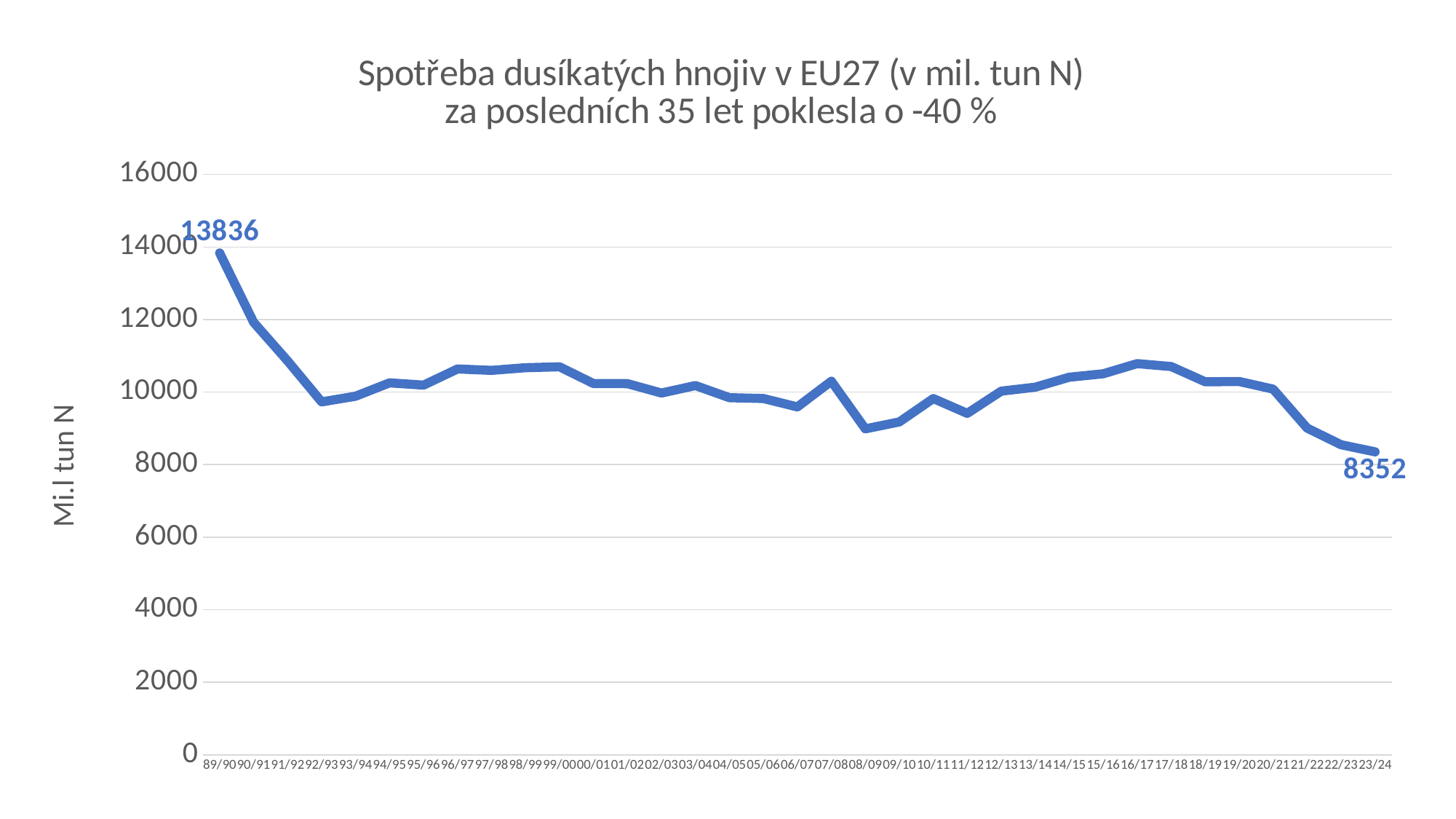
What is the value for 23/24? 8352 How many seasons are plotted on the x axis? 35 Which season has the highest value? 89/90 Is the value for 16/17 greater or less than 10000? greater What kind of chart is shown on the slide? line chart Do the values overall rise or fall from 89/90 to 23/24? fall What is the difference between the values for 89/90 and 23/24? 5484 What is the value for 89/90? 13836 Which is larger, the value for 89/90 or the value for 23/24? 89/90 Is the value for 08/09 greater or less than 10000? less What is the title of the vertical axis? Mi.l tun N Which season has the lowest value? 23/24